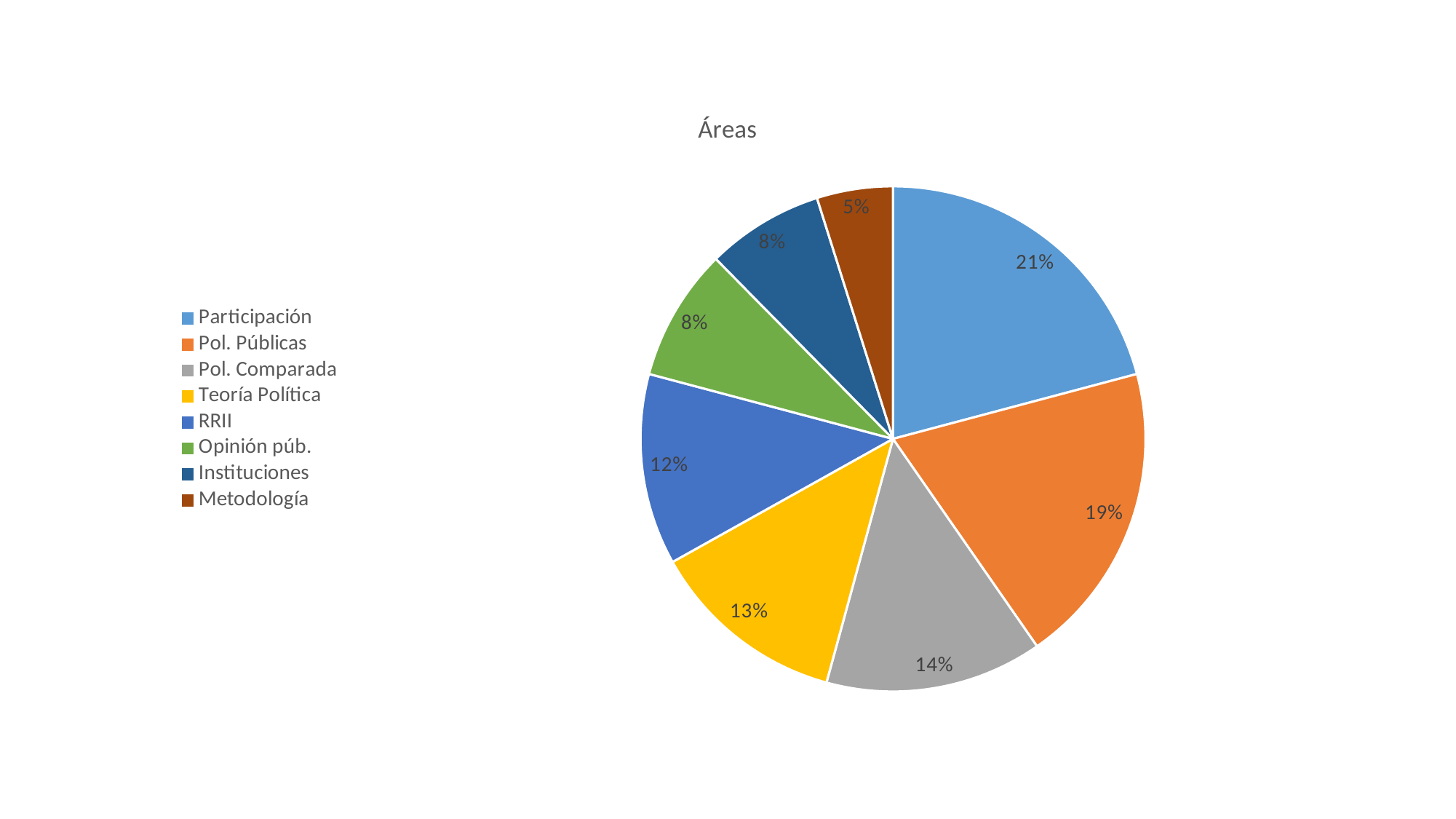
What share of the pie does Pol. Públicas have? 19% What is the value shown for RRII? 12% How many categories does the pie chart show? 8 What share of the pie does Participación have? 21% Which category has the smallest slice of the pie? Metodología What is the value shown for Pol. Comparada? 14% Which category has the largest slice of the pie? Participación What is the difference in percentage points between Participación and Metodología? 16 Which is larger, the slice for Pol. Comparada or the slice for RRII? Pol. Comparada What is the value shown for Metodología? 5% What is the value shown for Teoría Política? 13% What type of chart is shown on the slide? Pie chart